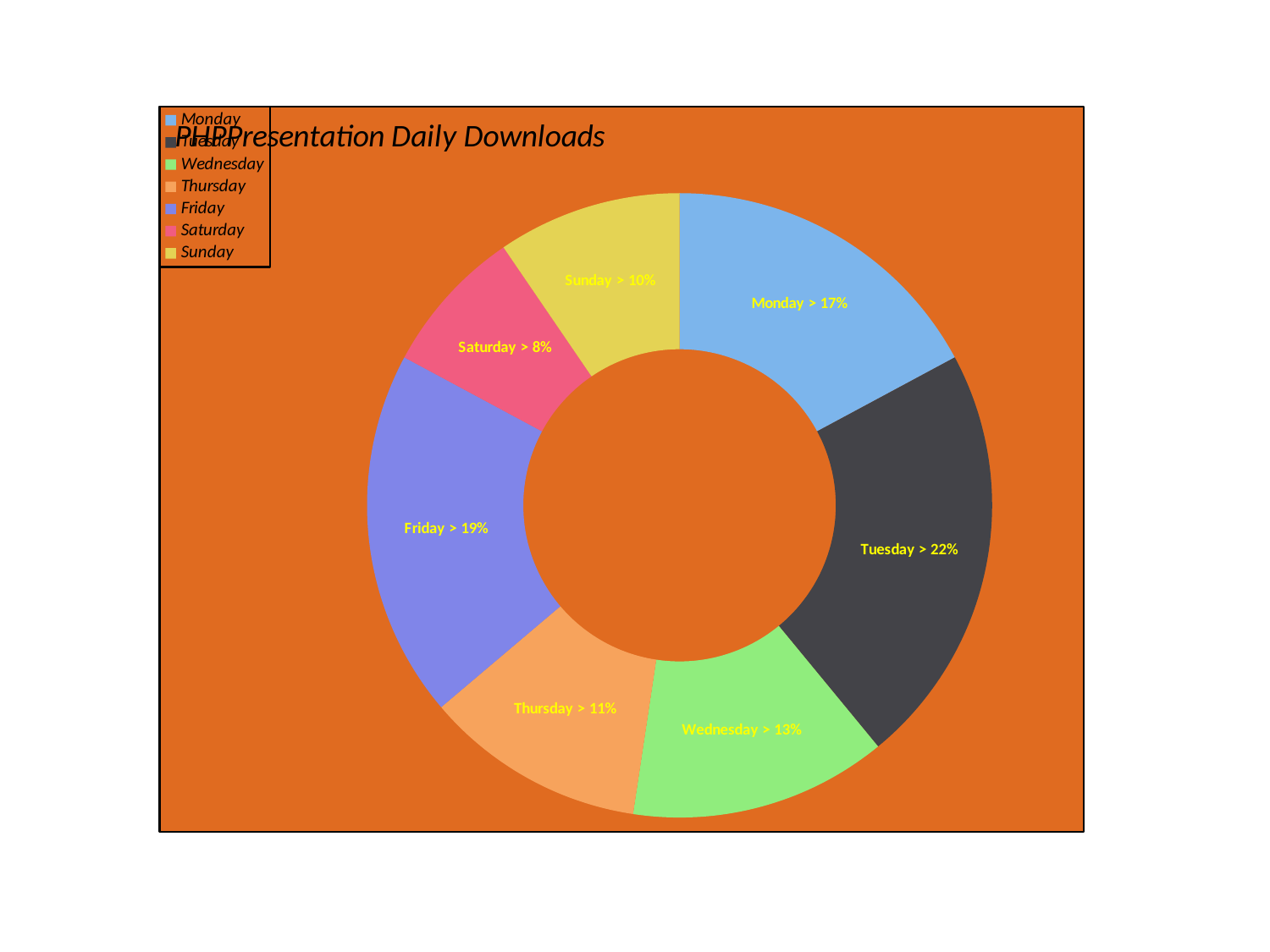
What share of daily downloads does Friday account for? 19% What share of daily downloads does Tuesday account for? 22% What kind of chart is shown on the slide? Doughnut (pie) chart How many days are shown in the chart? 7 Which has a larger share, Thursday or Sunday? Thursday Which day has the largest share of downloads? Tuesday What is the title of the chart? PHPPresentation Daily Downloads What colour is the Friday segment? Purple/blue What share of daily downloads does Wednesday account for? 13% Which day has the smallest share of downloads? Saturday What share of daily downloads does Saturday account for? 8% What is the difference in percentage points between Tuesday's and Monday's shares? 5